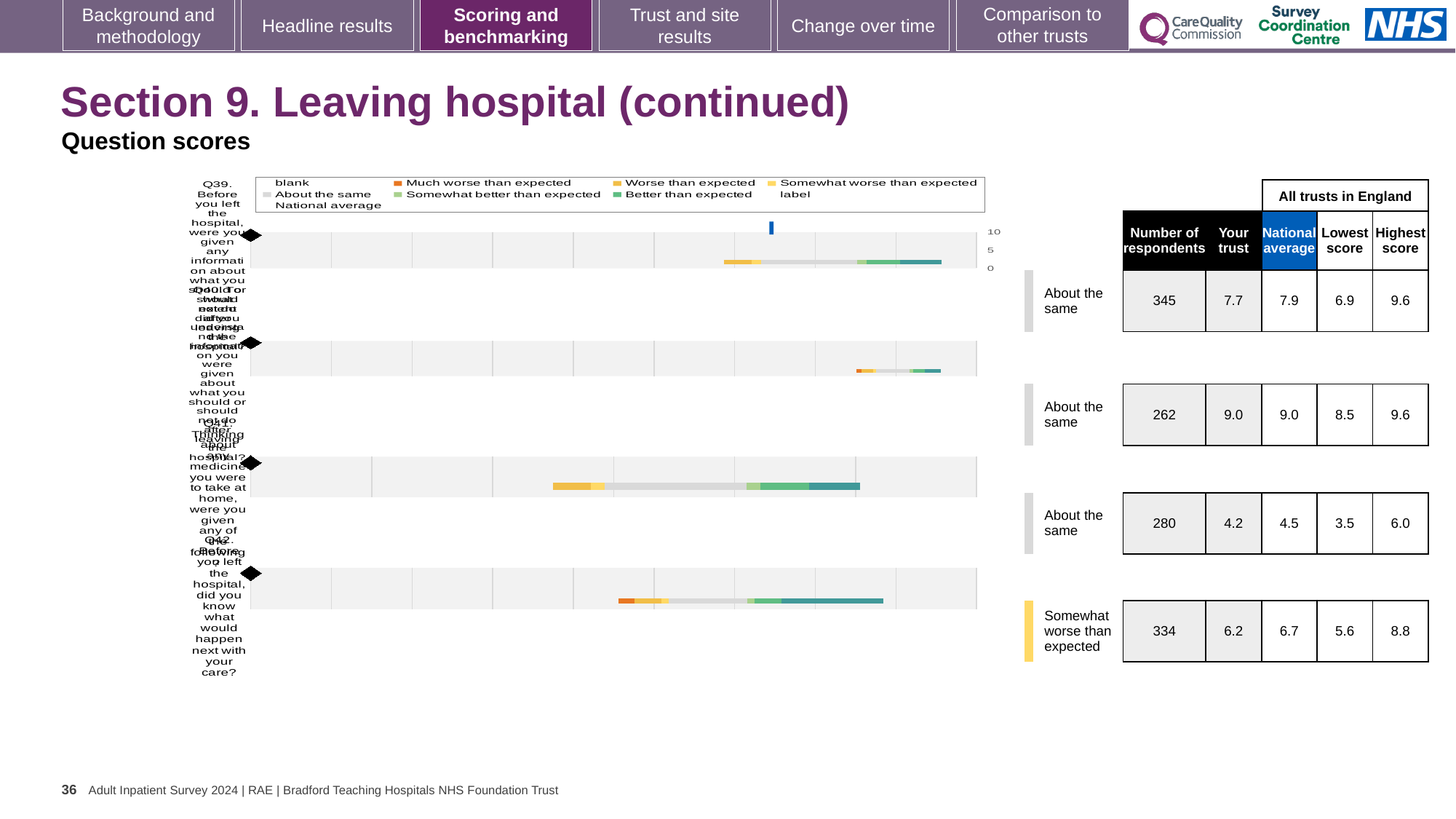
What benchmark category is shown for Q42 (the bottom row)? Somewhat worse than expected What kind of chart is shown on the slide? bar chart What is the highest score across all trusts in England for Q42 (the bottom row)? 8.8 Which row of the table has the highest 'Your trust' score? the second row (9.0) For Q39 (the top row), which is larger: the 'Your trust' score or the national average? national average What benchmark category is shown for Q39 (the top row)? About the same For Q42 (the bottom row), what is the difference between the national average and the 'Your trust' score? 0.5 What is the 'Your trust' score for Q39 (the top row) in the table? 7.7 In the table beside the chart, how many respondents are listed for Q39 (the top row)? 345 What is the national average for Q42 (the bottom row) in the table? 6.7 Which row of the table has the lowest 'Your trust' score? the third row (4.2) How many question bars are plotted in the chart? 4